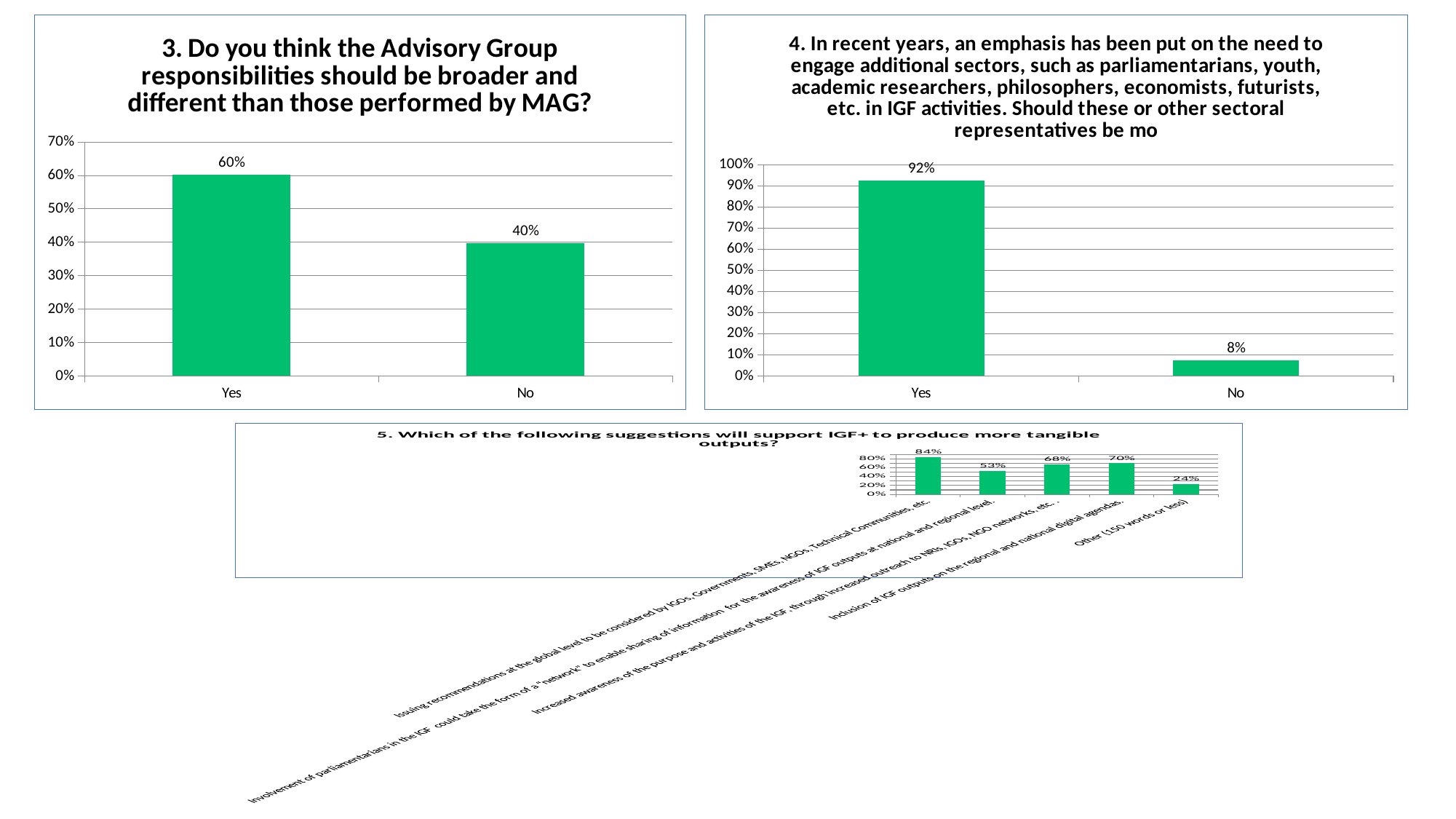
In the bottom chart (question 5), what is the value for "Other (150 words or less)"? 24% In the top-right chart (question 4), what is the value for Yes? 92% In the top-right chart (question 4), what is the value for No? 8% In the bottom chart (question 5), what is the value for "Inclusion of IGF outputs on the regional and national digital agendas"? 70% In the top-right chart (question 4), what is the difference between the Yes and No values? 84% What kind of chart is the top-left chart (question 3)? Bar chart In the top-left chart (question 3), what is the difference between the Yes and No values? 20% In the chart titled "3. Do you think the Advisory Group responsibilities should be broader and different than those performed by MAG?", what is the value for Yes? 60% In the chart titled "3. Do you think the Advisory Group responsibilities should be broader and different than those performed by MAG?", what is the value for No? 40% In the bottom chart (question 5), what is the highest value shown? 84% In the bottom chart titled "5. Which of the following suggestions will support IGF+ to produce more tangible outputs?", how many categories are plotted? 5 In the top-right chart (question 4), which category has the lowest value? No